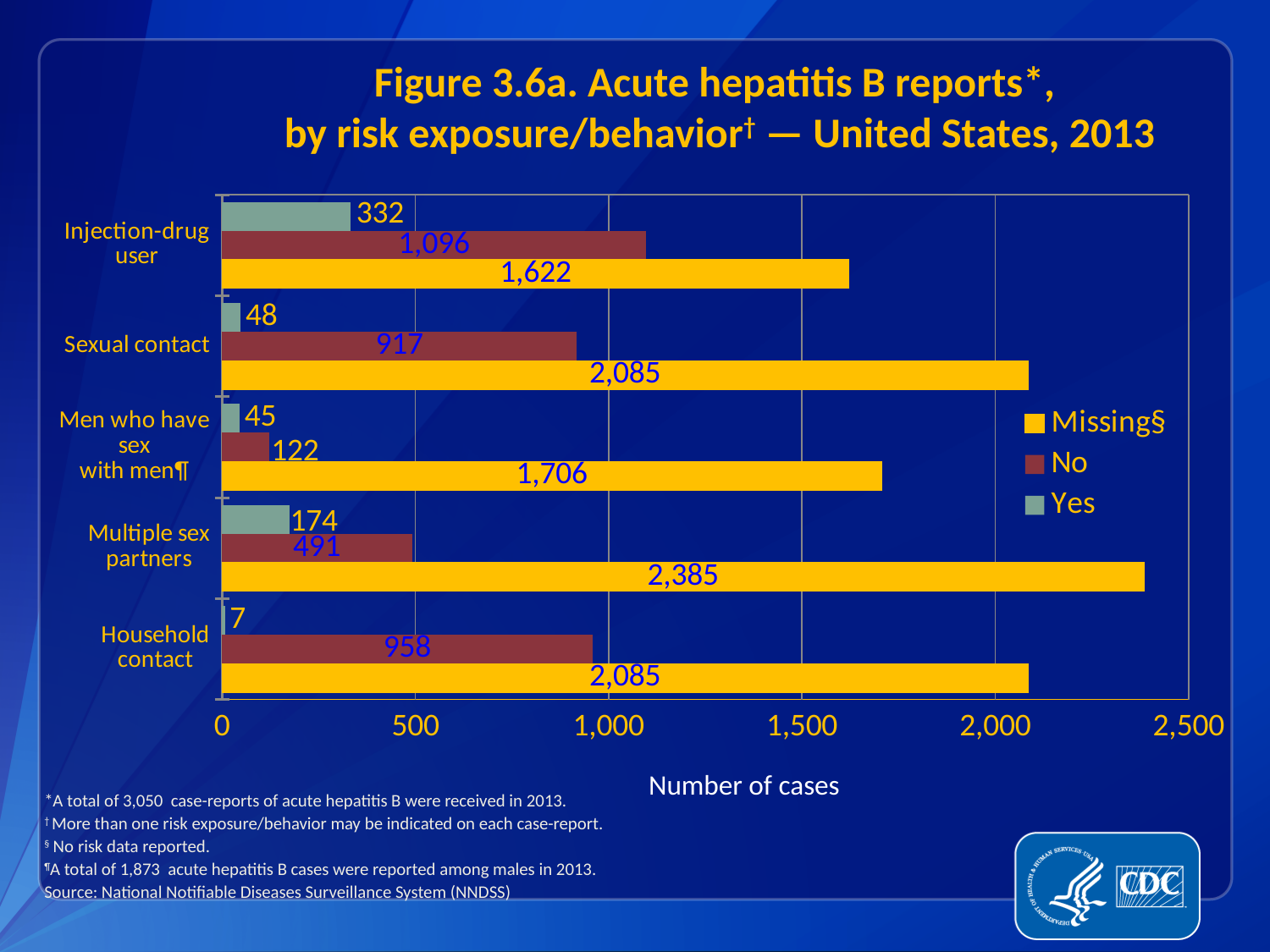
What is the difference between the 'No' values for Injection-drug user and Sexual contact? 179 How many series does the legend list? 3 What is the number of cases in the 'Missing' series for Multiple sex partners? 2,385 Which risk exposure/behavior category has the lowest value in the 'No' series? Men who have sex with men Which is larger: the 'Missing' value for Injection-drug user or for Men who have sex with men? Men who have sex with men How many risk exposure/behavior categories are shown on the chart? 5 What is the label of the x axis? Number of cases What is the number of cases in the 'Yes' series for Injection-drug user? 332 Which risk exposure/behavior category has the highest value in the 'Yes' series? Injection-drug user What kind of chart is shown on the slide? Bar chart What is the number of cases in the 'No' series for Household contact? 958 Is the 'Missing' value for Sexual contact greater or less than 2,000? greater